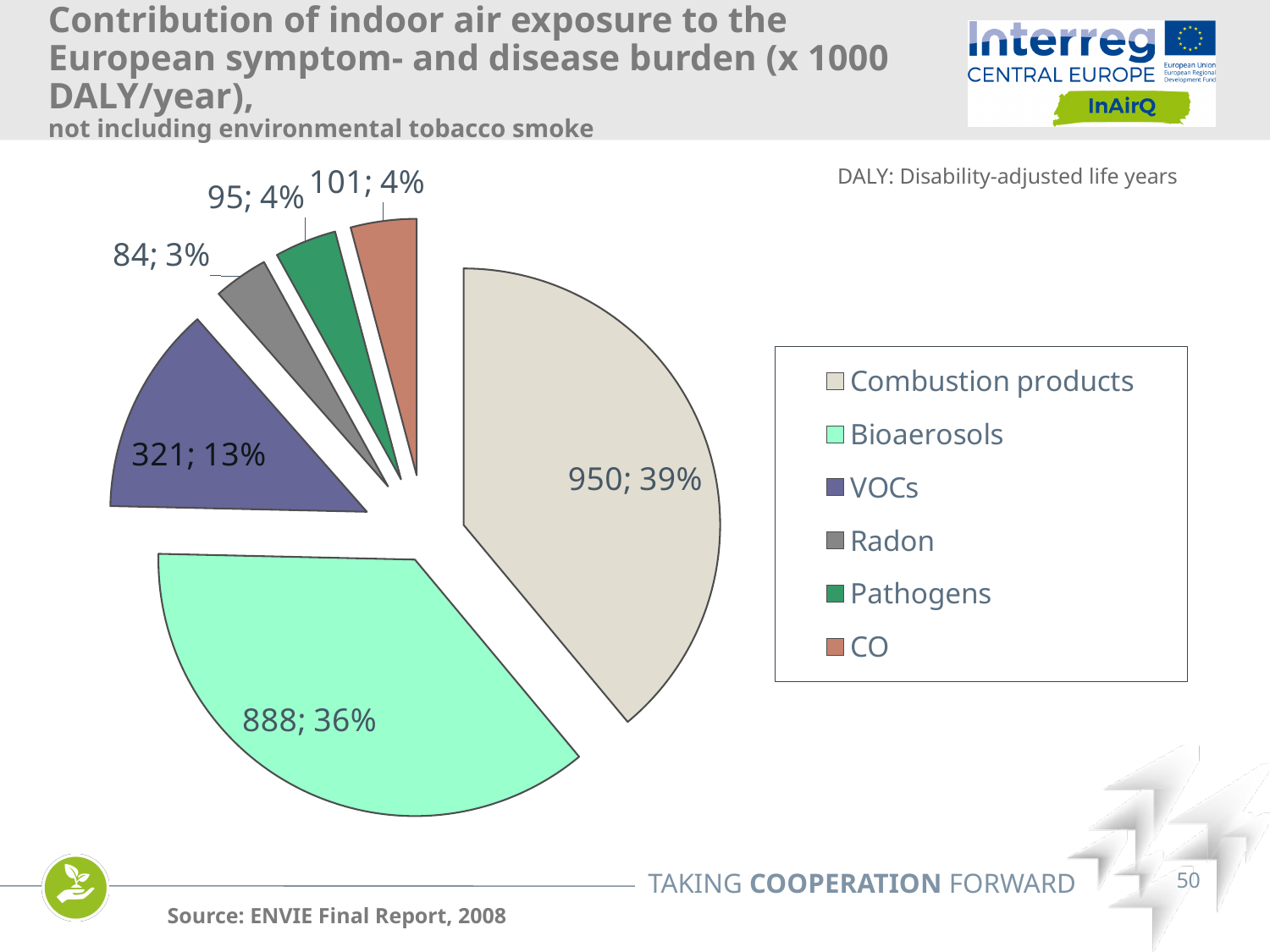
Which category has the largest slice of the pie? Combustion products What is the difference between the values for Combustion products and Bioaerosols? 62 What kind of chart is shown on the slide? pie chart What does the abbreviation DALY stand for according to the slide? Disability-adjusted life years What is the value shown for Combustion products? 950; 39% What is the value shown for Bioaerosols? 888; 36% Which category has the smallest slice of the pie? Radon What is the value shown for Radon? 84; 3% What is the value shown for VOCs? 321; 13% What share of the pie does Pathogens account for? 4% Which is larger, the value for CO or the value for Pathogens? CO How many categories does the legend of the pie chart list? 6